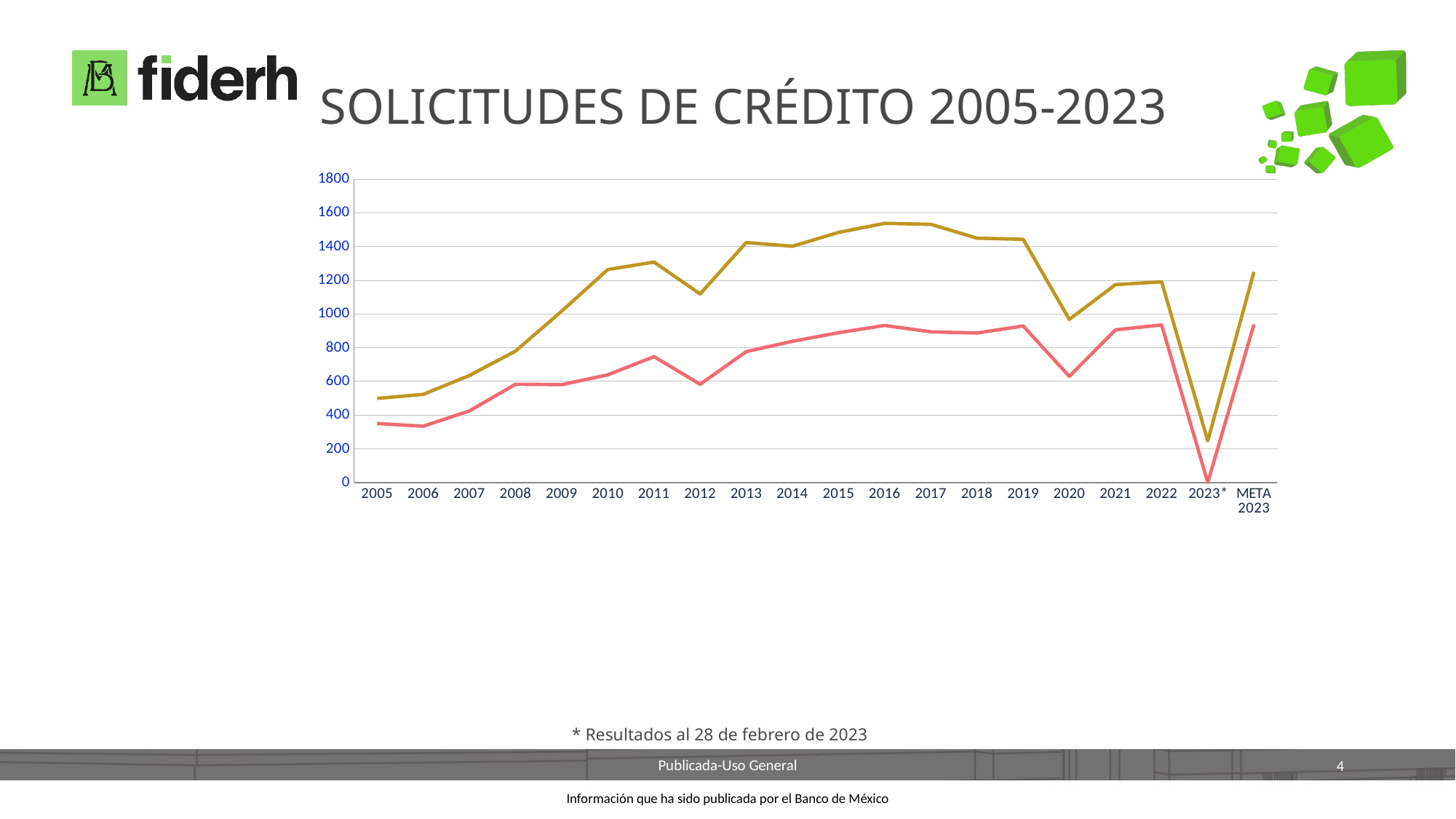
Is the value of the pink line for 2023* greater or less than 200? less Is the value of the gold line for 2016 greater or less than 1400? greater For which category is the gold line at its lowest value? 2023* What is the title of the chart on the slide? SOLICITUDES DE CRÉDITO 2005-2023 In 2016, which line has the larger value, the gold line or the pink line? the gold line Is the value of the gold line for 2010 greater or less than 1200? greater Does the gold line rise or fall from 2005 to 2011? rise How many categories are shown along the x axis of the chart? 20 What kind of chart is shown on the slide? line chart